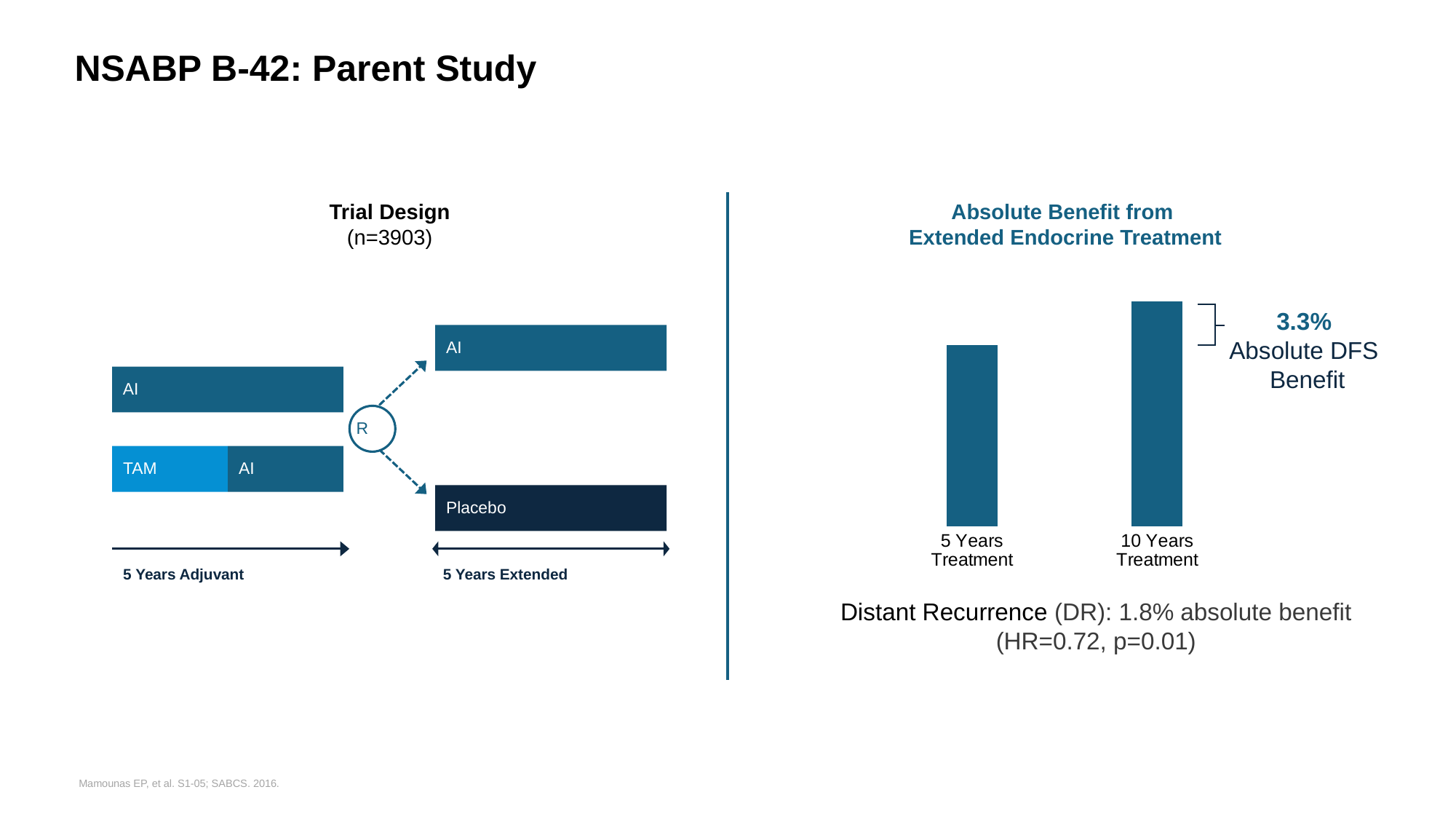
What is the title of the bar chart on the right side of the slide? Absolute Benefit from Extended Endocrine Treatment Do the bars in the "Absolute Benefit from Extended Endocrine Treatment" chart rise or fall from 5 Years Treatment to 10 Years Treatment? rise In the "Absolute Benefit from Extended Endocrine Treatment" chart, what absolute DFS benefit is labelled between the 5 Years Treatment and 10 Years Treatment bars? 3.3% What kind of chart is shown under the title "Absolute Benefit from Extended Endocrine Treatment"? bar chart In the "Absolute Benefit from Extended Endocrine Treatment" chart, is the bar for 5 Years Treatment or 10 Years Treatment larger? 10 Years Treatment In the "Absolute Benefit from Extended Endocrine Treatment" chart, which category has the taller bar? 10 Years Treatment How many bars are plotted in the "Absolute Benefit from Extended Endocrine Treatment" chart? 2 In the "Absolute Benefit from Extended Endocrine Treatment" chart, which category has the shorter bar? 5 Years Treatment What are the two category labels on the x axis of the bar chart on the right side of the slide? 5 Years Treatment and 10 Years Treatment